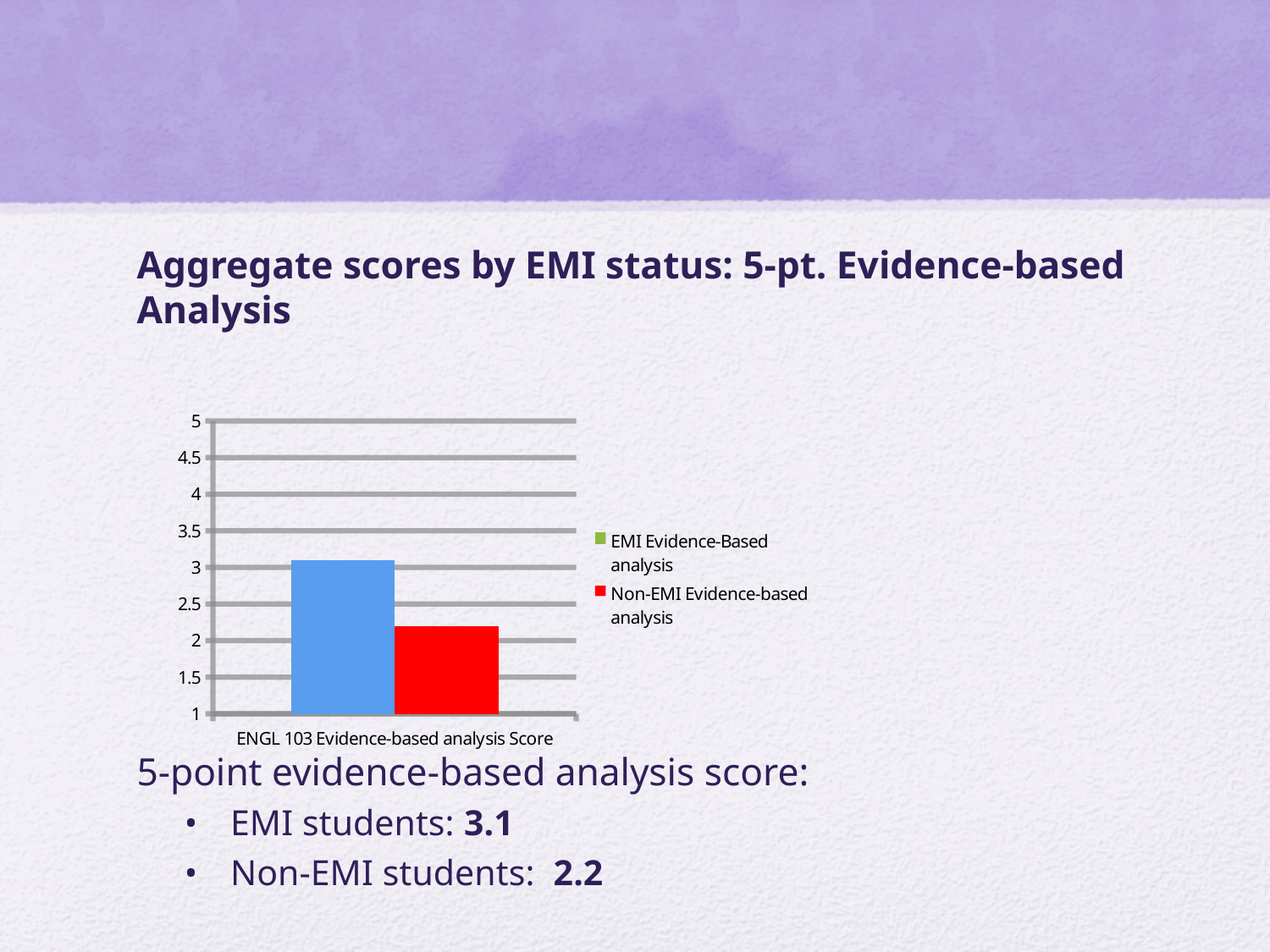
What is the difference between the EMI score and the Non-EMI score? 0.9 Is the EMI Evidence-Based analysis bar greater or less than 2.5? greater Which series has the higher bar in the chart, EMI or Non-EMI evidence-based analysis? EMI Evidence-Based analysis How many categories are shown on the x axis of the chart? 1 What is the maximum value shown on the chart's y axis? 5 What is the category label on the x axis of the chart? ENGL 103 Evidence-based analysis Score How many series does the chart legend list? 2 What type of chart is shown on the slide? bar chart Is the Non-EMI Evidence-based analysis bar greater or less than 2.5? less Which series has the lower bar in the chart? Non-EMI Evidence-based analysis What is the EMI evidence-based analysis score shown on the slide? 3.1 What is the Non-EMI evidence-based analysis score shown on the slide? 2.2